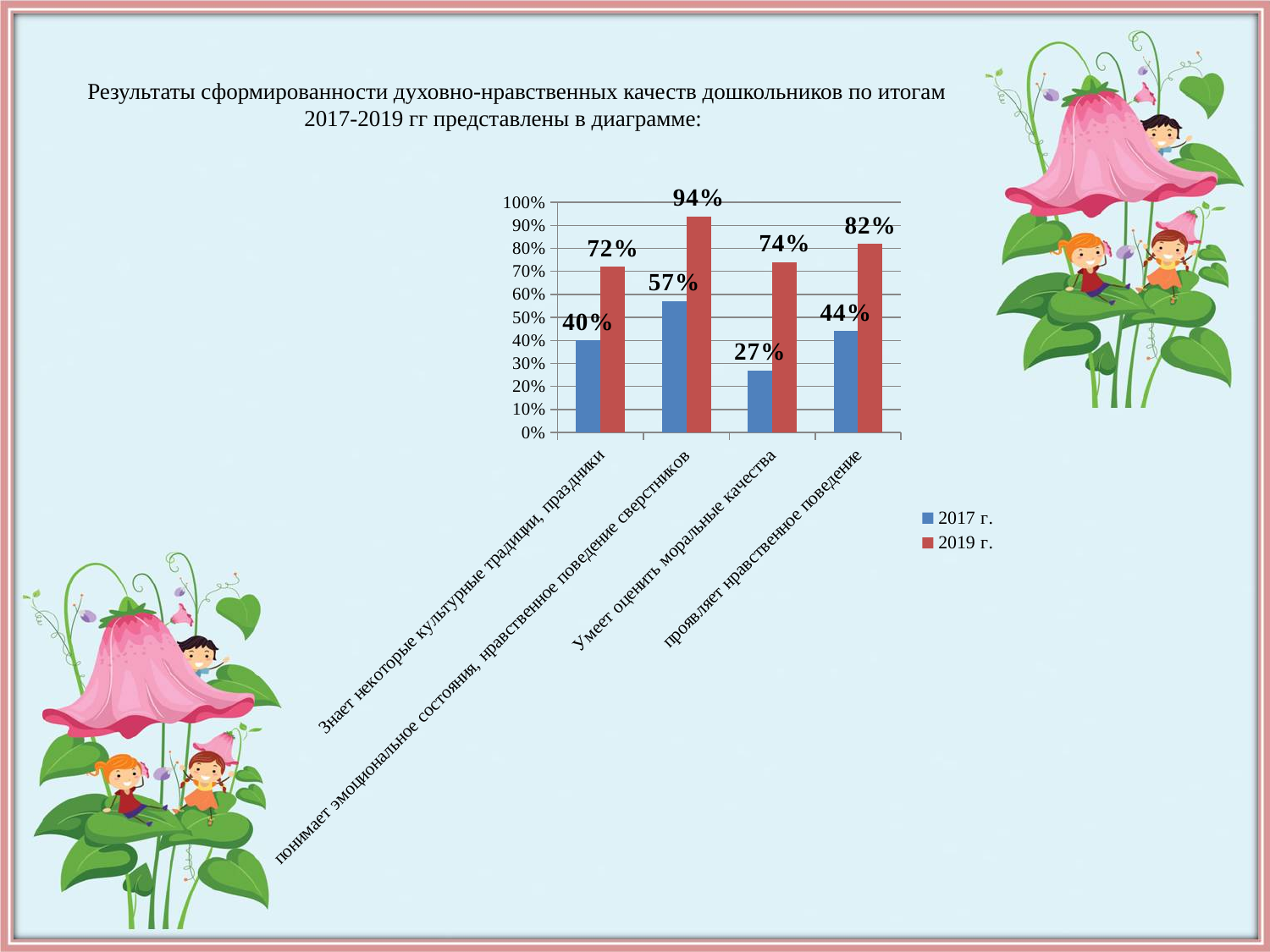
Which is larger: the 2017 г. value for 'понимает эмоциональное состояния, нравственное поведение сверстников' or the 2017 г. value for 'проявляет нравственное поведение'? понимает эмоциональное состояния, нравственное поведение сверстников How many categories are shown on the x axis of the chart? 4 Which colour represents the 2019 г. series in the chart? red Which category has the highest value for 2019 г.? понимает эмоциональное состояния, нравственное поведение сверстников Which category has the lowest value for 2017 г.? Умеет оценить моральные качества What type of chart is shown on the slide? bar chart How many series does the legend list? 2 What is the value for 2017 г. in the category 'Знает некоторые культурные традиции, праздники'? 40% What is the difference between the 2019 г. and 2017 г. values in the category 'Умеет оценить моральные качества'? 47% What is the value for 2019 г. in the category 'Умеет оценить моральные качества'? 74% Is the 2019 г. value for 'Знает некоторые культурные традиции, праздники' greater or less than 70%? greater What is the value for 2019 г. in the category 'проявляет нравственное поведение'? 82%